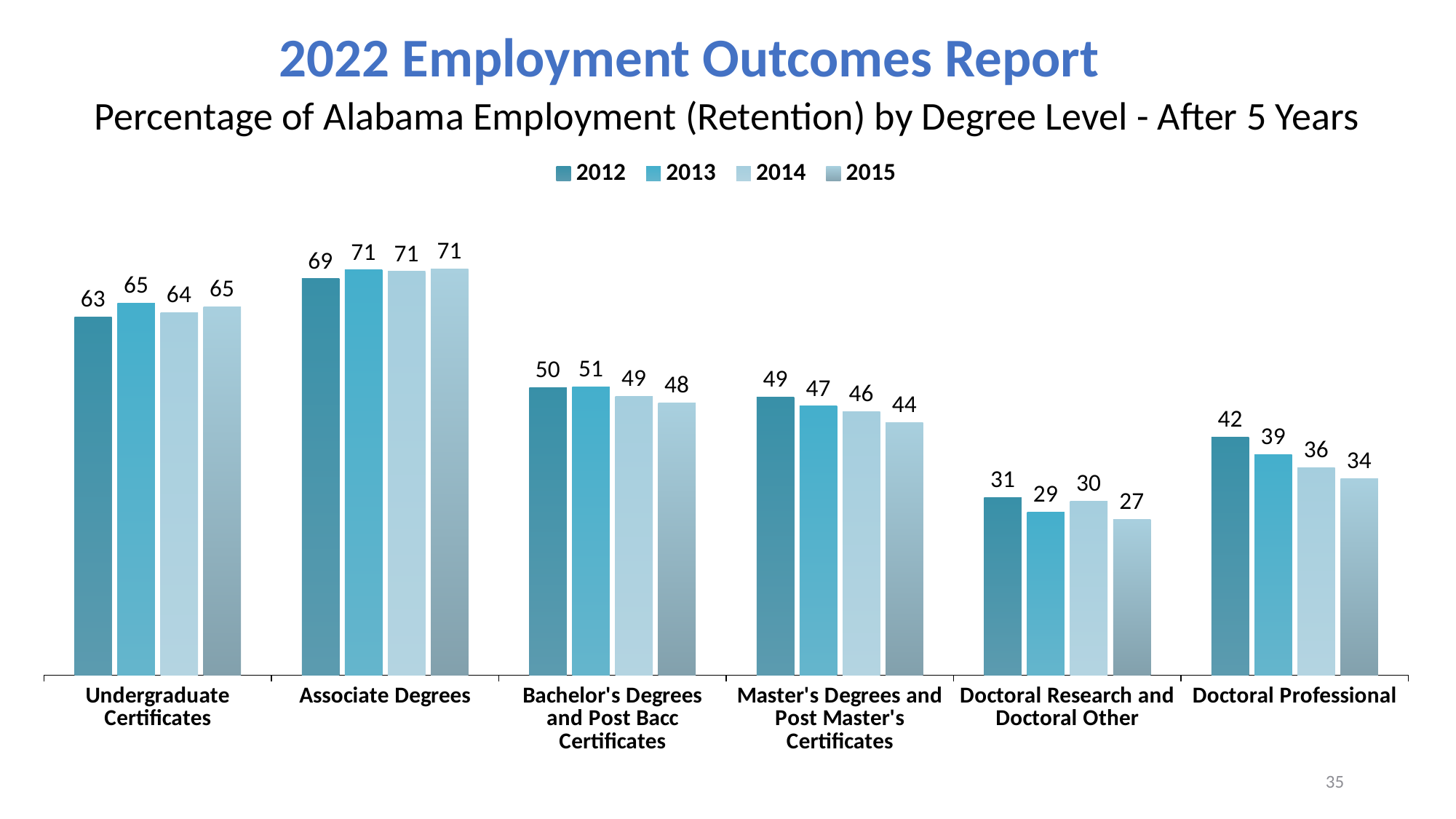
What kind of chart is shown on the slide? Bar chart What is the difference between the 2012 and 2015 values for Doctoral Professional? 8 What years are listed in the chart's legend? 2012, 2013, 2014, 2015 What is the value for Associate Degrees in the 2012 series? 69 How many degree-level categories are shown on the x axis? 6 Which degree level has the lowest value in the 2015 series? Doctoral Research and Doctoral Other What is the value for Doctoral Professional in the 2015 series? 34 Which degree level has the highest value in the 2013 series? Associate Degrees What is the value for Master's Degrees and Post Master's Certificates in the 2014 series? 46 Do the 2015 values rise or fall from Associate Degrees to Doctoral Research and Doctoral Other? Fall How many series does the legend list? 4 Which is larger for Bachelor's Degrees and Post Bacc Certificates: the 2012 value or the 2013 value? 2013